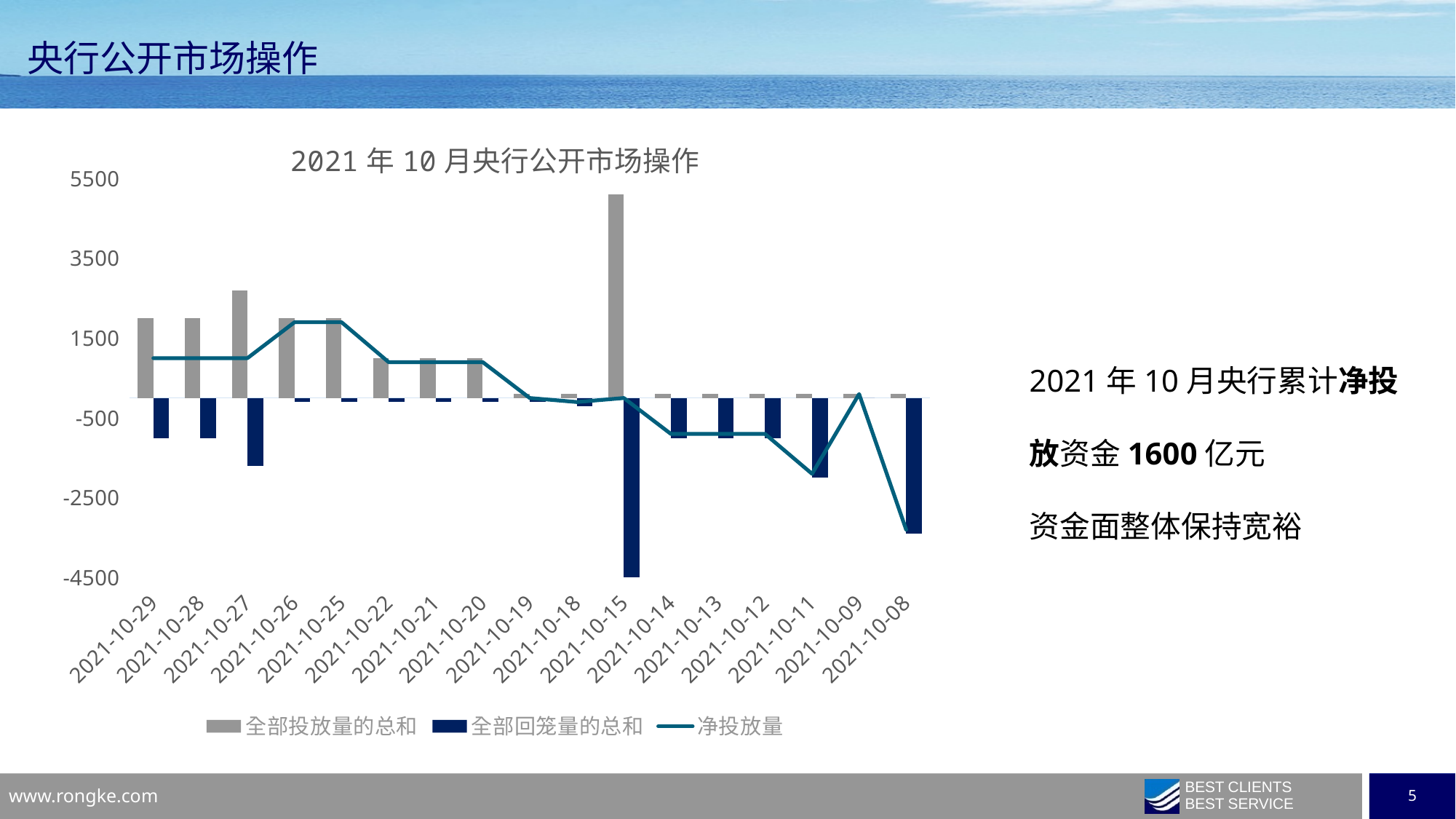
What is the title of the chart? 2021年10月央行公开市场操作 Is the 全部回笼量的总和 value for 2021-10-08 greater or less than -2500? less Does the 净投放量 line overall rise or fall from left to right across the x axis? fall Which series is drawn as a line in the chart? 净投放量 Is the 全部投放量的总和 value for 2021-10-15 greater or less than 3500? greater Which date has the larger 全部投放量的总和 bar, 2021-10-27 or 2021-10-29? 2021-10-27 How many dates are shown on the x axis of the chart? 17 How many series does the chart legend list? 3 Is the 净投放量 value for 2021-10-26 greater or less than 1500? greater On which date is the 全部投放量的总和 bar the highest? 2021-10-15 What kind of chart is shown on the slide? Combined bar and line chart On which date is the 全部回笼量的总和 bar the lowest (most negative)? 2021-10-15